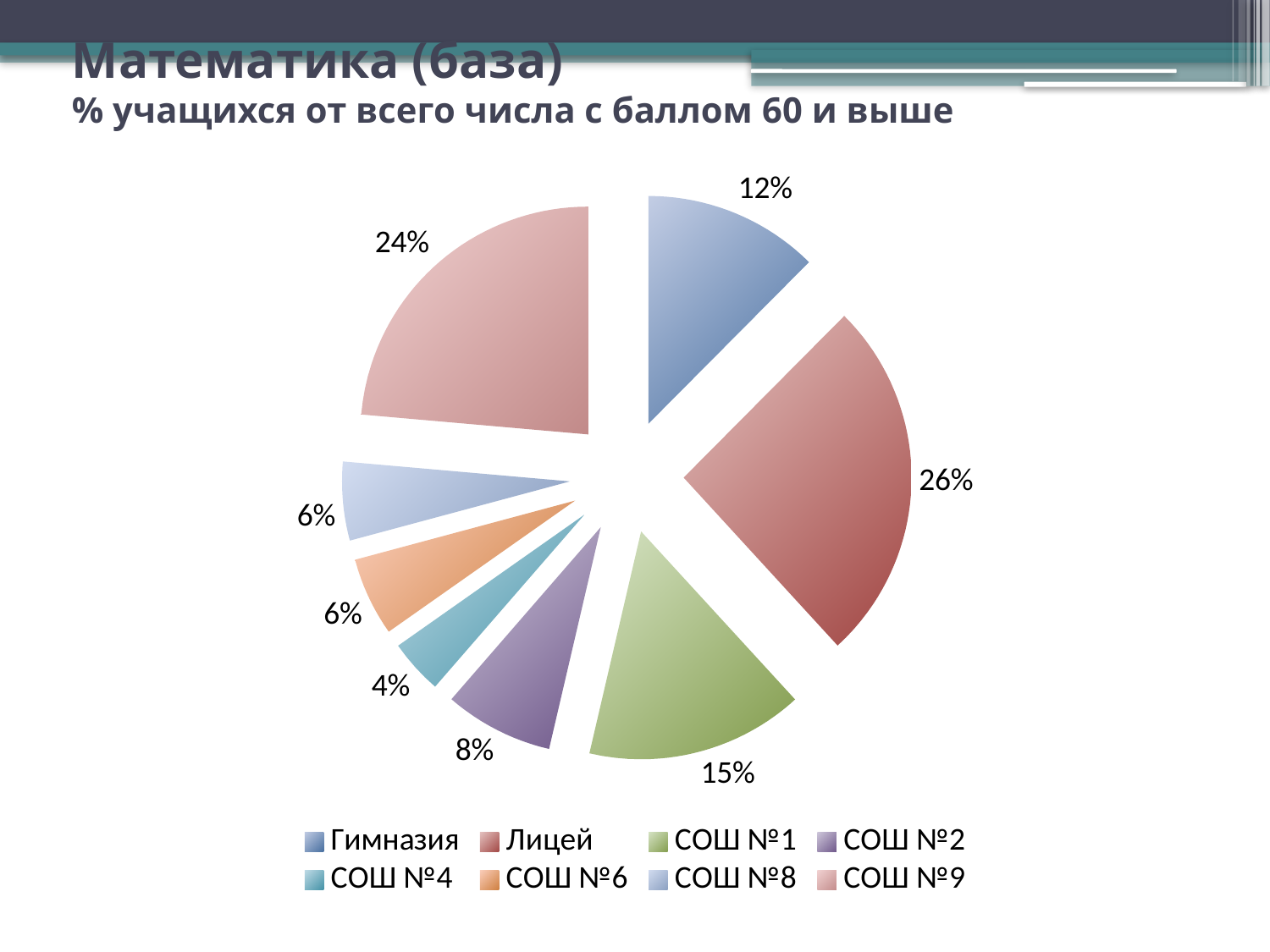
What percentage is shown for СОШ №9? 24% Which school has the largest share of the pie? Лицей What percentage is shown for СОШ №1? 15% What type of chart is shown on the slide? pie chart What percentage is shown for Лицей? 26% What percentage is shown for Гимназия? 12% Which school has the smallest share of the pie? СОШ №4 What percentage is shown for СОШ №4? 4% What is the difference in percentage points between Лицей and СОШ №9? 2 Which is larger, the share for СОШ №1 or the share for СОШ №2? СОШ №1 How many schools are listed in the legend? 8 What is the title of the chart on the slide? Математика (база) % учащихся от всего числа с баллом 60 и выше